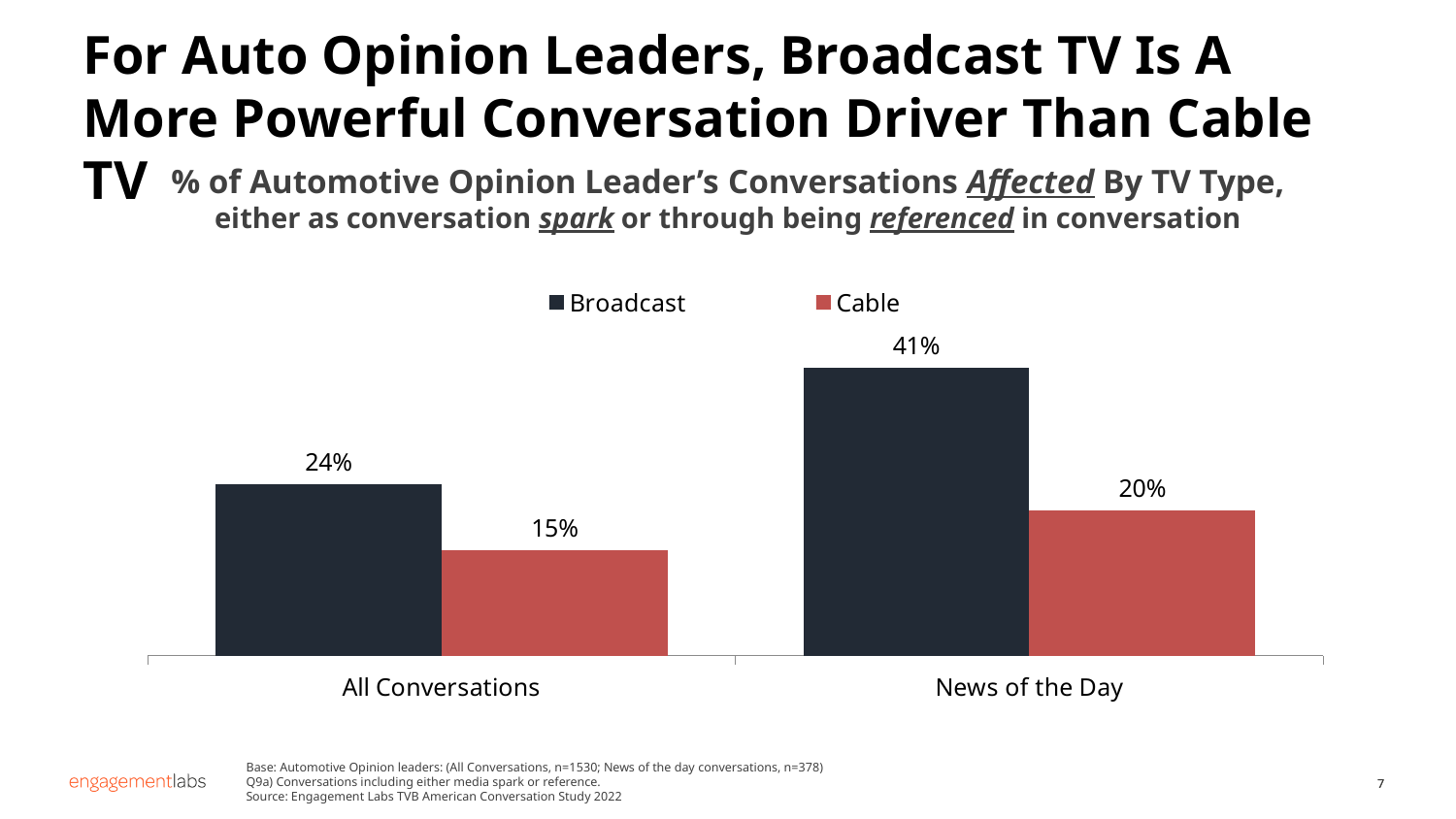
Which series has the lowest value for All Conversations? Cable How many series does the legend list? 2 What is the difference between the Broadcast and Cable values for News of the Day? 21% How many categories are shown on the x axis? 2 Which is larger for All Conversations, Broadcast or Cable? Broadcast What is the Cable value for News of the Day? 20% What is the Broadcast value for All Conversations? 24% What is the Cable value for All Conversations? 15% Which colour represents the Cable series in the legend? Red What kind of chart is shown on the slide? Bar chart Which category has the highest Broadcast value? News of the Day What is the difference between the Broadcast values for News of the Day and All Conversations? 17%